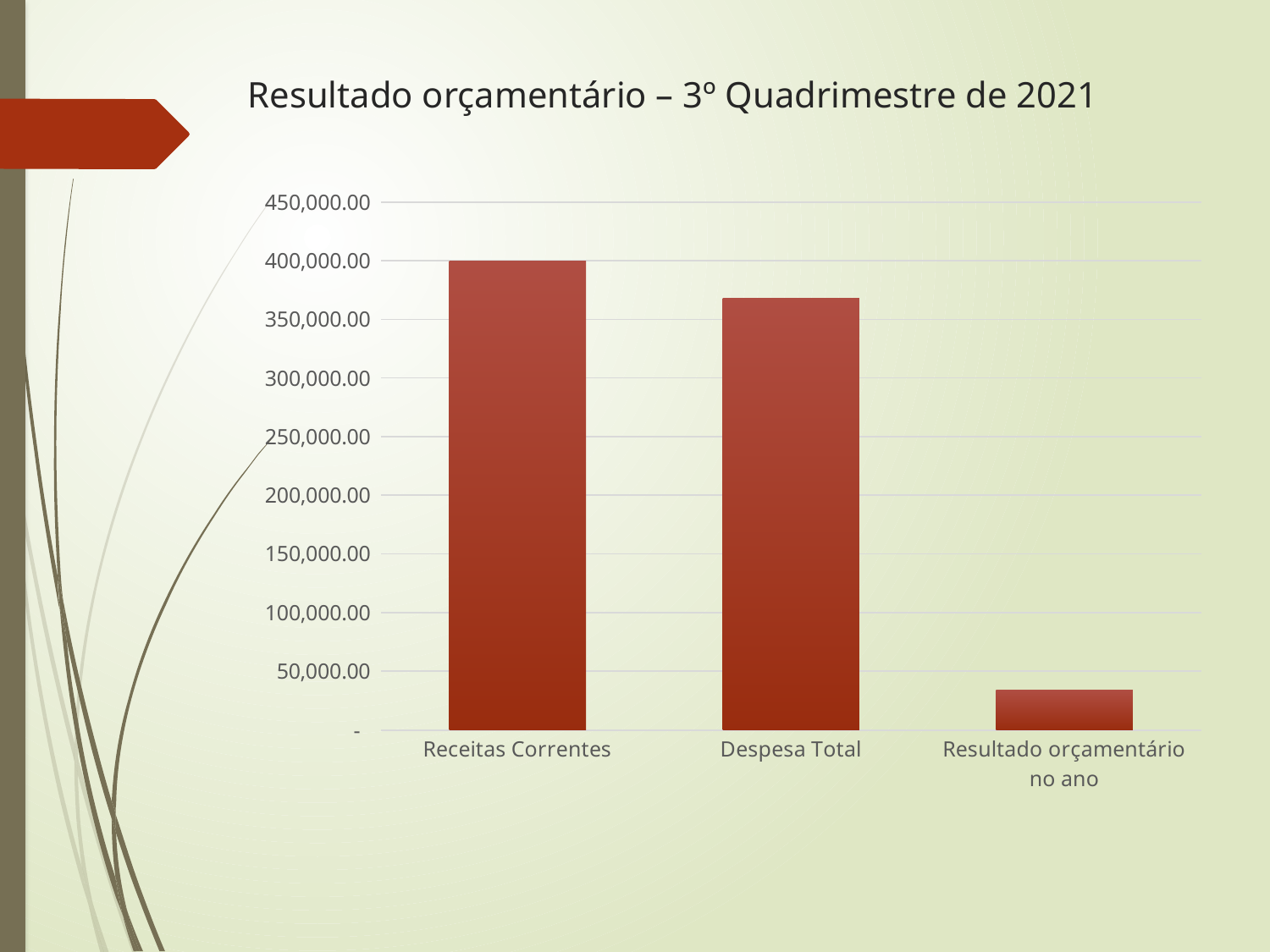
How many categories are plotted in the chart? 3 Is the value for Resultado orçamentário no ano greater or less than 50,000.00? less Is the value for Receitas Correntes greater or less than 350,000.00? greater Do the values rise or fall from left to right across the categories? fall What is the title of the slide's chart? Resultado orçamentário – 3º Quadrimestre de 2021 Which category has the highest value? Receitas Correntes What kind of chart is shown on the slide? bar chart Is the value for Despesa Total greater or less than 350,000.00? greater Which is larger, Receitas Correntes or Despesa Total? Receitas Correntes Which is larger, Despesa Total or Resultado orçamentário no ano? Despesa Total Which category has the lowest value? Resultado orçamentário no ano